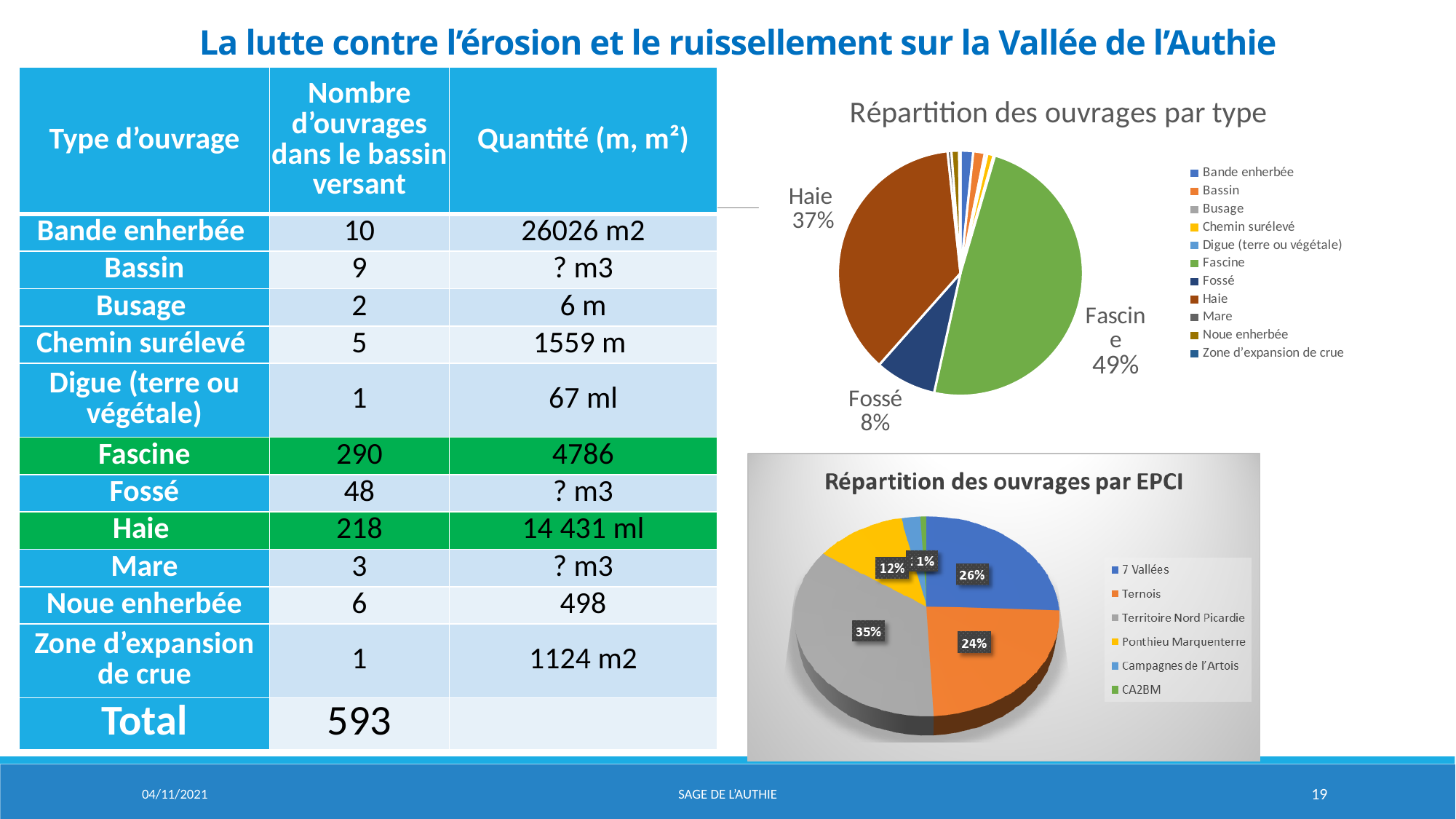
In the chart titled 'Répartition des ouvrages par EPCI', what share does 7 Vallées represent? 26% In the chart titled 'Répartition des ouvrages par EPCI', what share does Ponthieu Marquenterre represent? 12% In the chart titled 'Répartition des ouvrages par type', how many entries does the legend list? 11 In the chart titled 'Répartition des ouvrages par type', which category has the largest slice? Fascine In the chart titled 'Répartition des ouvrages par EPCI', which EPCI has the largest slice? Territoire Nord Picardie In the chart titled 'Répartition des ouvrages par type', what share of the pie does Haie represent? 37% In the chart titled 'Répartition des ouvrages par EPCI', how many EPCIs does the legend list? 6 What kind of chart is 'Répartition des ouvrages par type'? Pie chart In the chart titled 'Répartition des ouvrages par EPCI', which is larger, the share for 7 Vallées or the share for Ternois? 7 Vallées